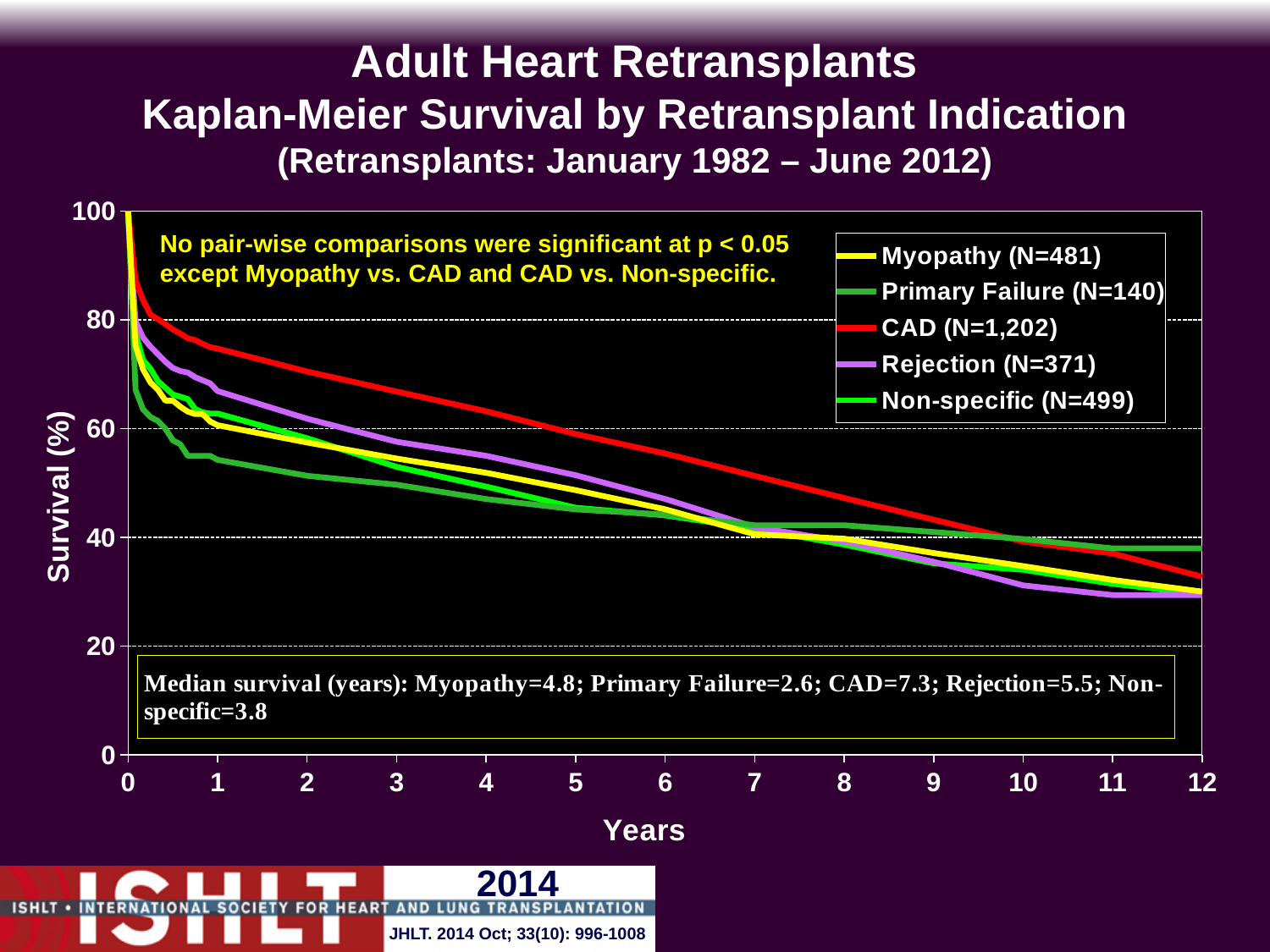
What is the median survival in years for the CAD group? 7.3 At 12 years, which has higher survival, Primary Failure or Rejection? Primary Failure What is the median survival in years for the Primary Failure group? 2.6 Is the survival for CAD at 3 years greater or less than 60? greater Do the survival curves rise or fall as years increase? fall What is the difference in median survival (years) between CAD and Primary Failure? 4.7 How many series does the legend list? 5 What is the N for the CAD group shown in the legend? N=1,202 Is the survival for Rejection at 12 years greater or less than 40? less Which retransplant indication has the lowest median survival? Primary Failure Which retransplant indication has the highest median survival? CAD What kind of chart is shown on the slide? line chart